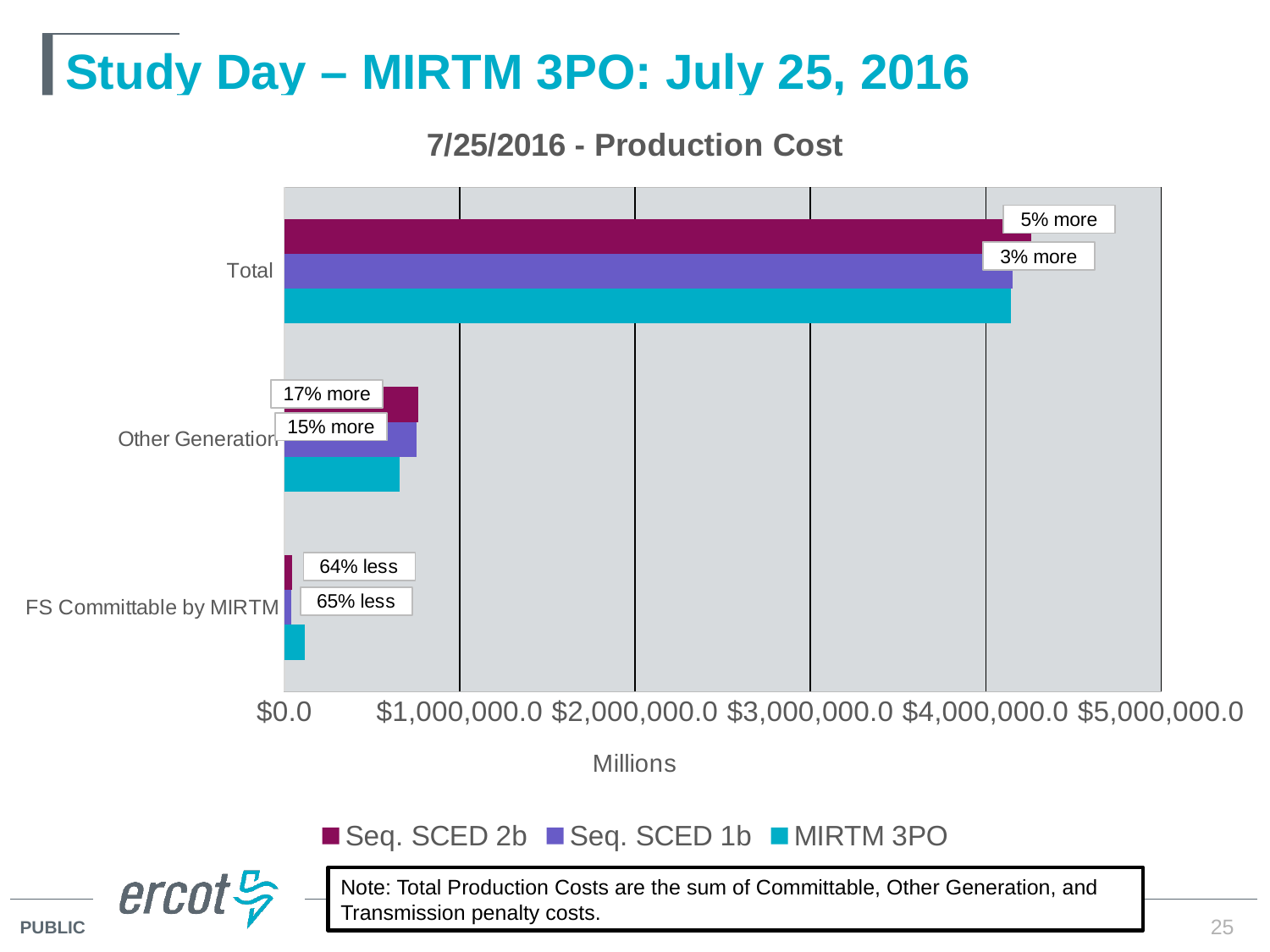
Is the Seq. SCED 2b value for Total greater or less than $4,000,000.0? greater How many categories are shown on the vertical axis? 3 Is the Seq. SCED 2b value for Other Generation greater or less than $1,000,000.0? less For Total, which is larger: Seq. SCED 2b or MIRTM 3PO? Seq. SCED 2b Which category has the highest production cost? Total How many series does the legend list? 3 What does the label next to the Seq. SCED 1b bar for FS Committable by MIRTM say? 65% less What does the label next to the Seq. SCED 2b bar for Other Generation say? 17% more Which category has the lowest production cost? FS Committable by MIRTM For FS Committable by MIRTM, which is larger: MIRTM 3PO or Seq. SCED 2b? MIRTM 3PO What is the title of the chart? 7/25/2016 - Production Cost What kind of chart is shown on the slide? bar chart